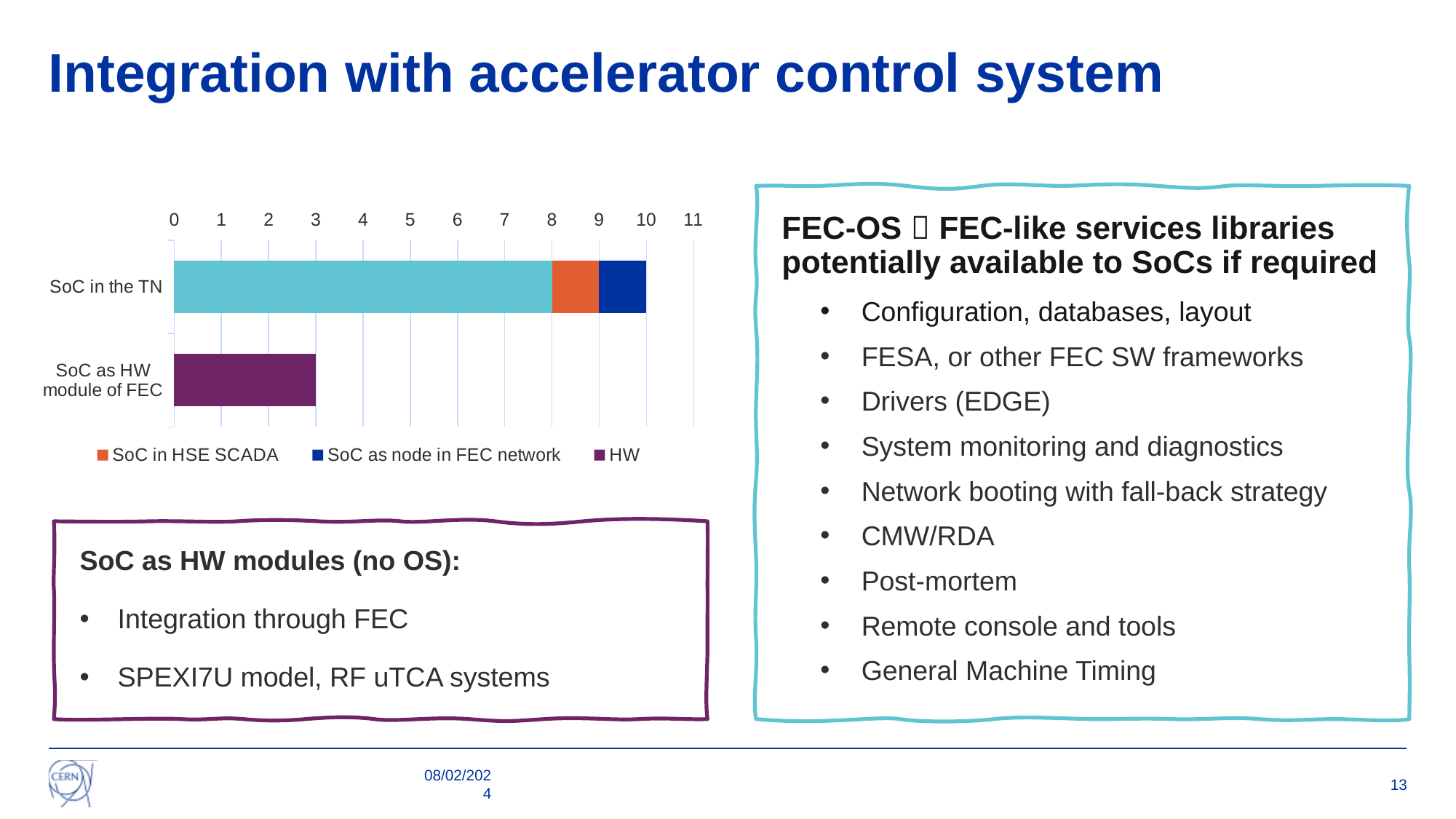
Which category has the highest total value? SoC in the TN What colour represents the HW series in the legend? purple How many series does the chart legend list? 3 Which category has the longer bar, "SoC in the TN" or "SoC as HW module of FEC"? SoC in the TN What is the "SoC as node in FEC network" value for "SoC in the TN"? 1 What kind of chart is shown on the slide? bar chart What is the total length of the stacked bar for "SoC in the TN"? 10 How many categories are plotted on the vertical axis of the chart? 2 Is the value for "SoC as HW module of FEC" greater or less than 5? less What is the HW value for "SoC as HW module of FEC"? 3 What is the "SoC in HSE SCADA" value for "SoC in the TN"? 1 Is the total for "SoC in the TN" greater or less than 8? greater